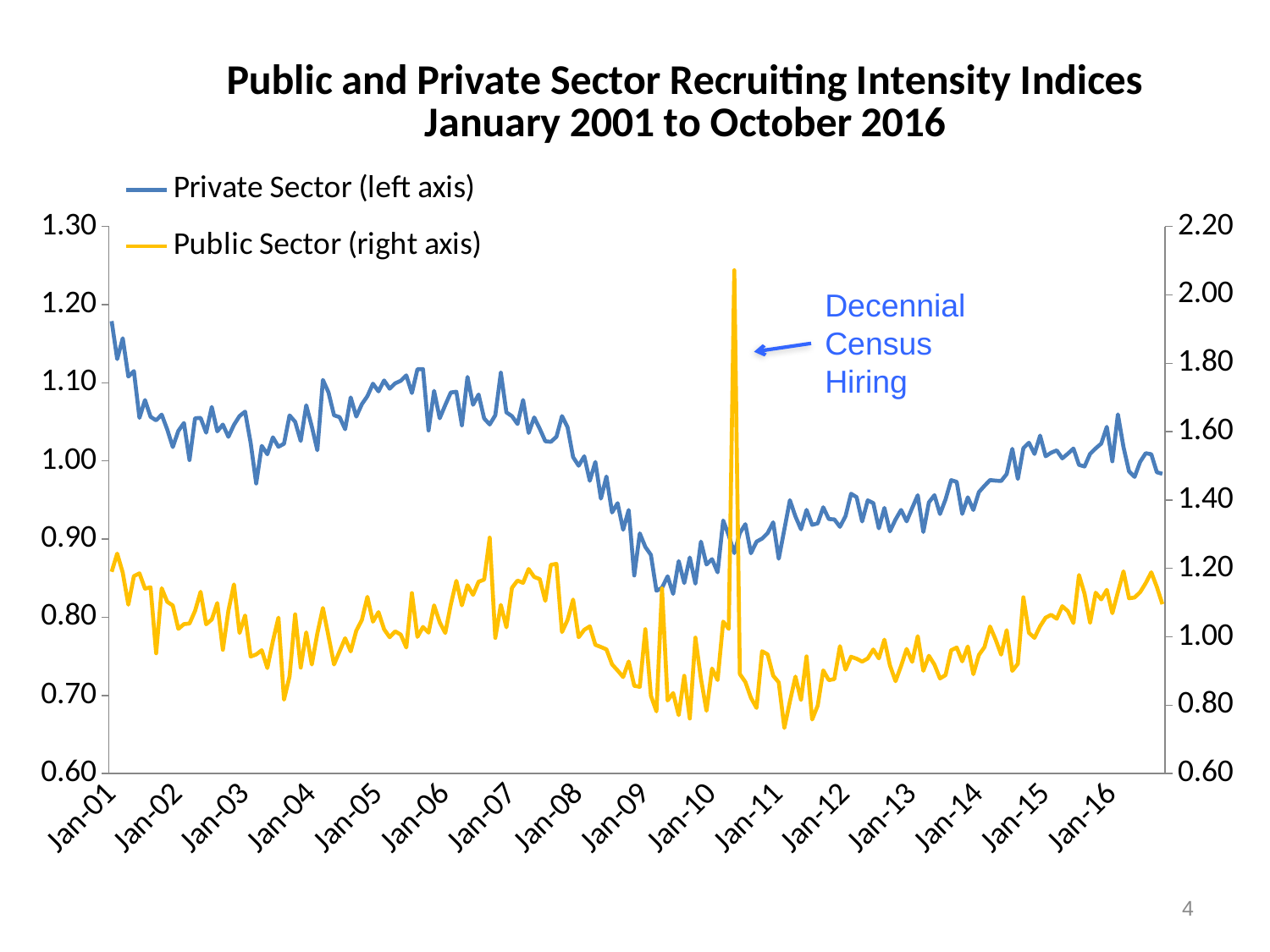
Is the Private Sector value at Jan-01 greater or less than 1.10? greater Does the Public Sector series generally rise or fall between Jan-13 and Jan-16? rise Is the Public Sector value at Jan-11 greater or less than 1.00 on the right axis? less How many year labels are shown on the x axis? 16 Is the peak Public Sector value (the spike labelled Decennial Census Hiring) greater or less than 2.00 on the right axis? greater Does the Private Sector series rise or fall between Jan-08 and Jan-09? fall Which axis is the Public Sector series plotted against, according to the legend? right axis How many series does the legend list? 2 What is the title of the chart? Public and Private Sector Recruiting Intensity Indices January 2001 to October 2016 What kind of chart is shown on the slide? line chart